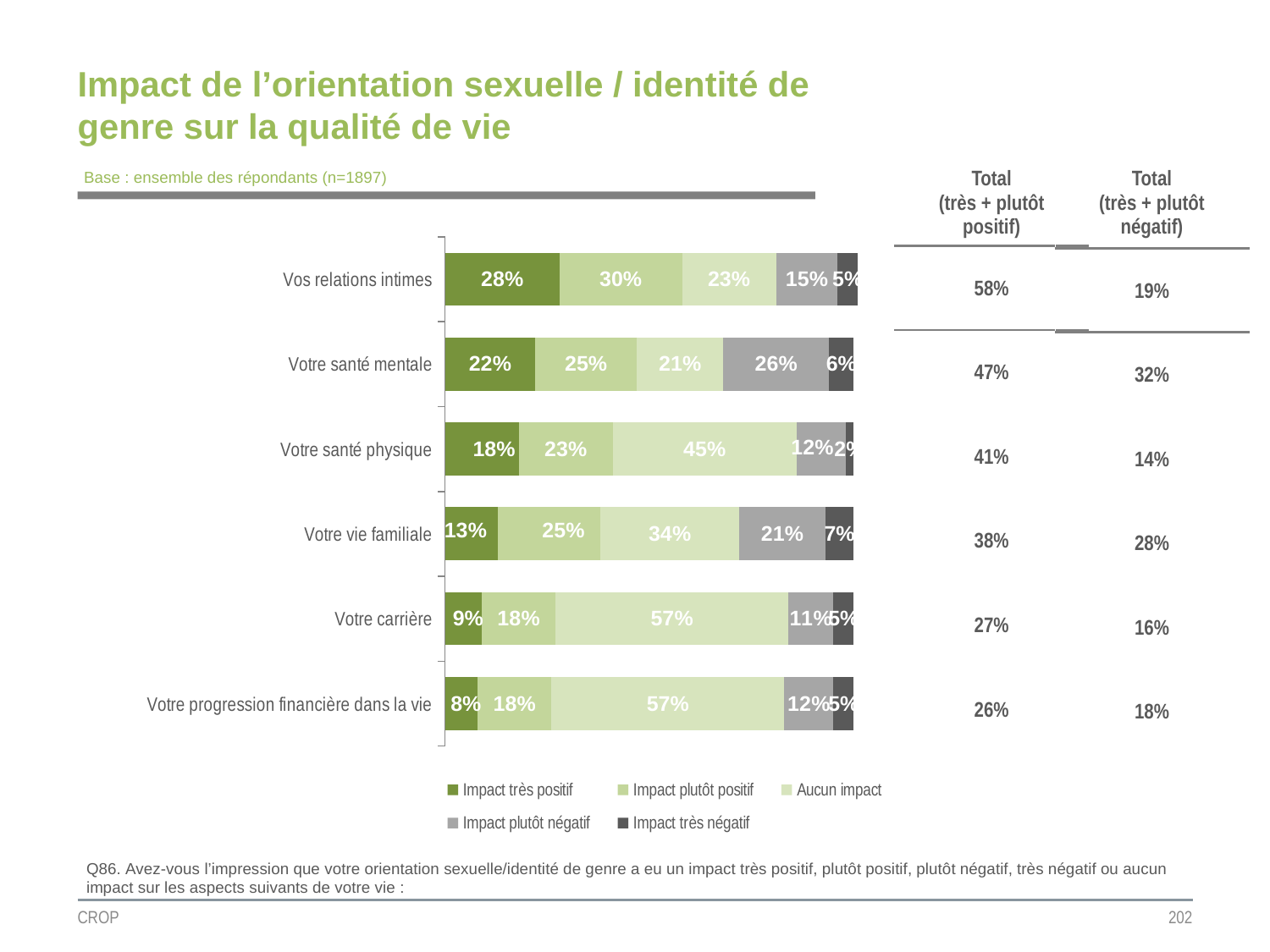
What is the value of 'Impact plutôt négatif' for 'Votre santé mentale'? 26% Which category has the lowest value for 'Impact très positif'? Votre progression financière dans la vie Which legend entry is shown in the darkest green colour? Impact très positif How many series does the chart legend list? 5 What is the value of 'Impact très négatif' for 'Votre vie familiale'? 7% What is the difference between the 'Aucun impact' values for 'Votre santé physique' and 'Votre santé mentale'? 24 percentage points Which category has the highest value for 'Impact très positif'? Vos relations intimes What kind of chart is shown on the slide? Stacked bar chart What is the value of 'Aucun impact' for 'Votre carrière'? 57% Which has the larger 'Impact plutôt positif' value: 'Vos relations intimes' or 'Votre santé mentale'? Vos relations intimes How many categories (aspects of life) are plotted in the chart? 6 What is the value of 'Impact très positif' for 'Vos relations intimes'? 28%